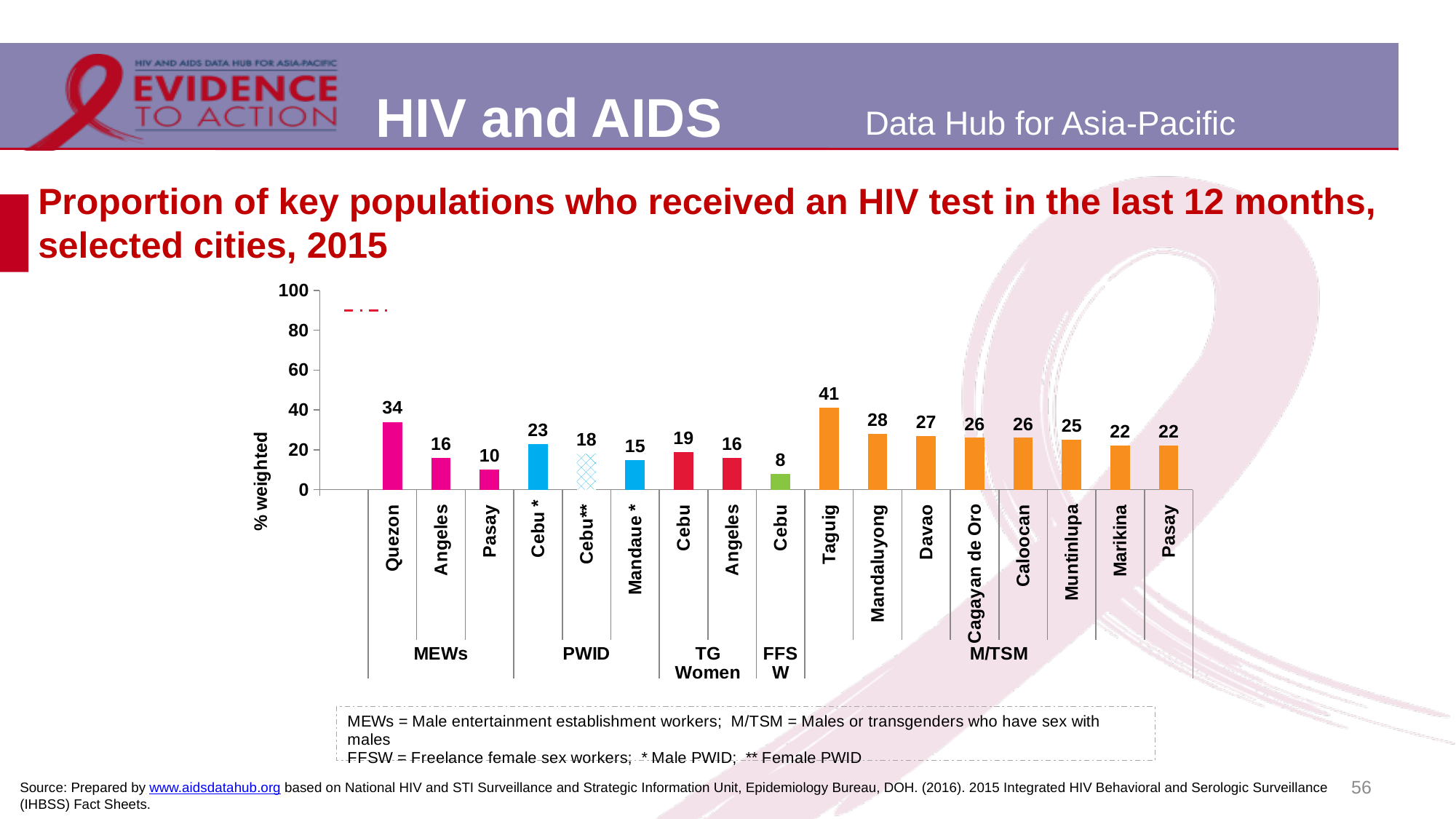
What is the difference between the values for Quezon and Pasay in the MEWs group? 24 What is the difference between the values for Taguig and Mandaluyong? 13 What is the value for Taguig in the M/TSM group? 41 Which city has the highest value on the chart? Taguig How many bars are plotted on the chart? 17 Which is larger, the value for Cebu * (PWID) or the value for Cebu (TG Women)? Cebu * (PWID) What is the label of the vertical axis? % weighted What kind of chart is shown on the slide? Bar chart What is the value for Cebu in the FFSW group? 8 What is the value for Mandaue * in the PWID group? 15 Which city has the lowest value on the chart? Cebu (FFSW) What is the value for Quezon in the MEWs group? 34